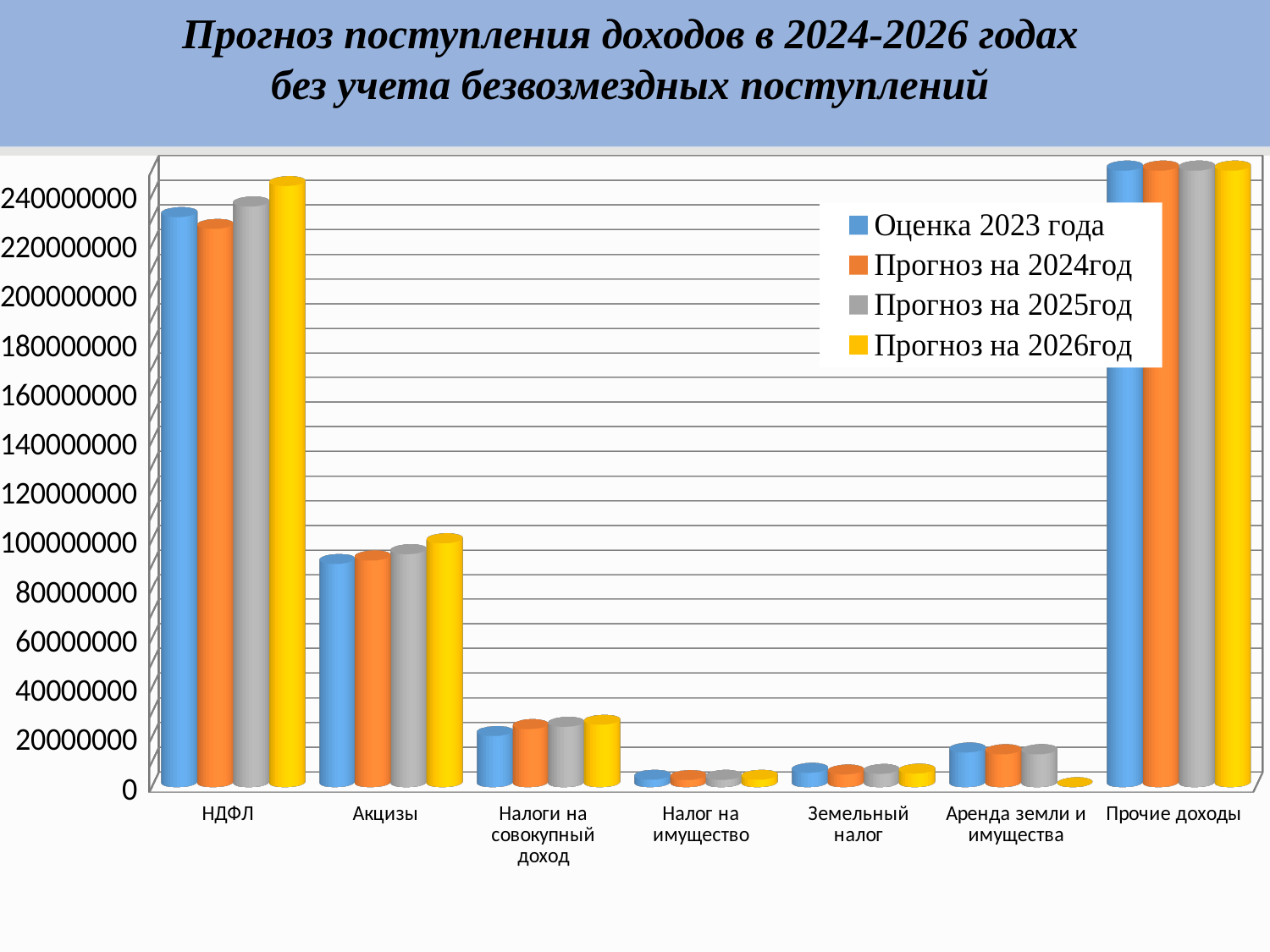
What kind of chart is shown on the slide? bar chart Do the values for Акцизы rise or fall from Оценка 2023 года to Прогноз на 2026год? rise Which category has the highest value for the series Прогноз на 2026год? Прочие доходы Is the value for Прочие доходы in the series Прогноз на 2024год greater or less than 240000000? greater How many series does the legend list? 4 Which category has the highest value for the series Оценка 2023 года? Прочие доходы Is the value for НДФЛ in the series Оценка 2023 года greater or less than 220000000? greater Which is larger for Аренда земли и имущества: Оценка 2023 года or Прогноз на 2026год? Оценка 2023 года Is the value for Налог на имущество in the series Оценка 2023 года greater or less than 20000000? less How many categories are shown along the x axis of the chart? 7 Which is larger for the series Оценка 2023 года: НДФЛ or Акцизы? НДФЛ